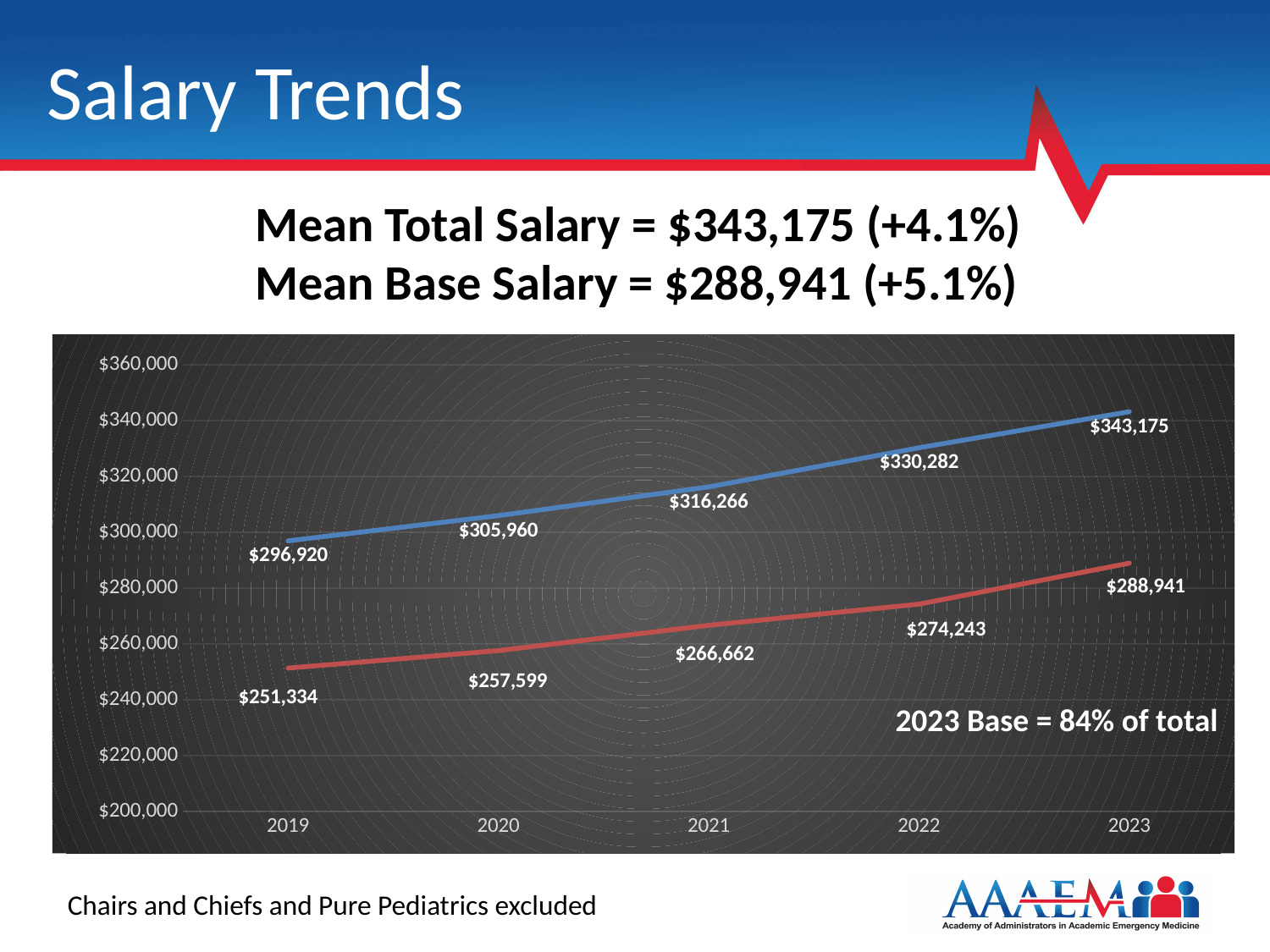
What is the mean total salary value plotted for 2019? $296,920 In which year is the mean total salary highest? 2023 What is the mean base salary value plotted for 2022? $274,243 What is the mean base salary value plotted for 2020? $257,599 Which is larger, the mean base salary in 2023 or the mean total salary in 2019? Mean total salary in 2019 In which year is the mean base salary lowest? 2019 What type of chart is shown on the slide? Line chart What is the difference between the mean total salary and the mean base salary in 2023? $54,234 Do the mean total salary values rise or fall from 2019 to 2023? Rise How many years are shown on the x axis of the chart? 5 By how much did the mean total salary increase from 2019 to 2023? $46,255 What is the mean total salary value plotted for 2021? $316,266